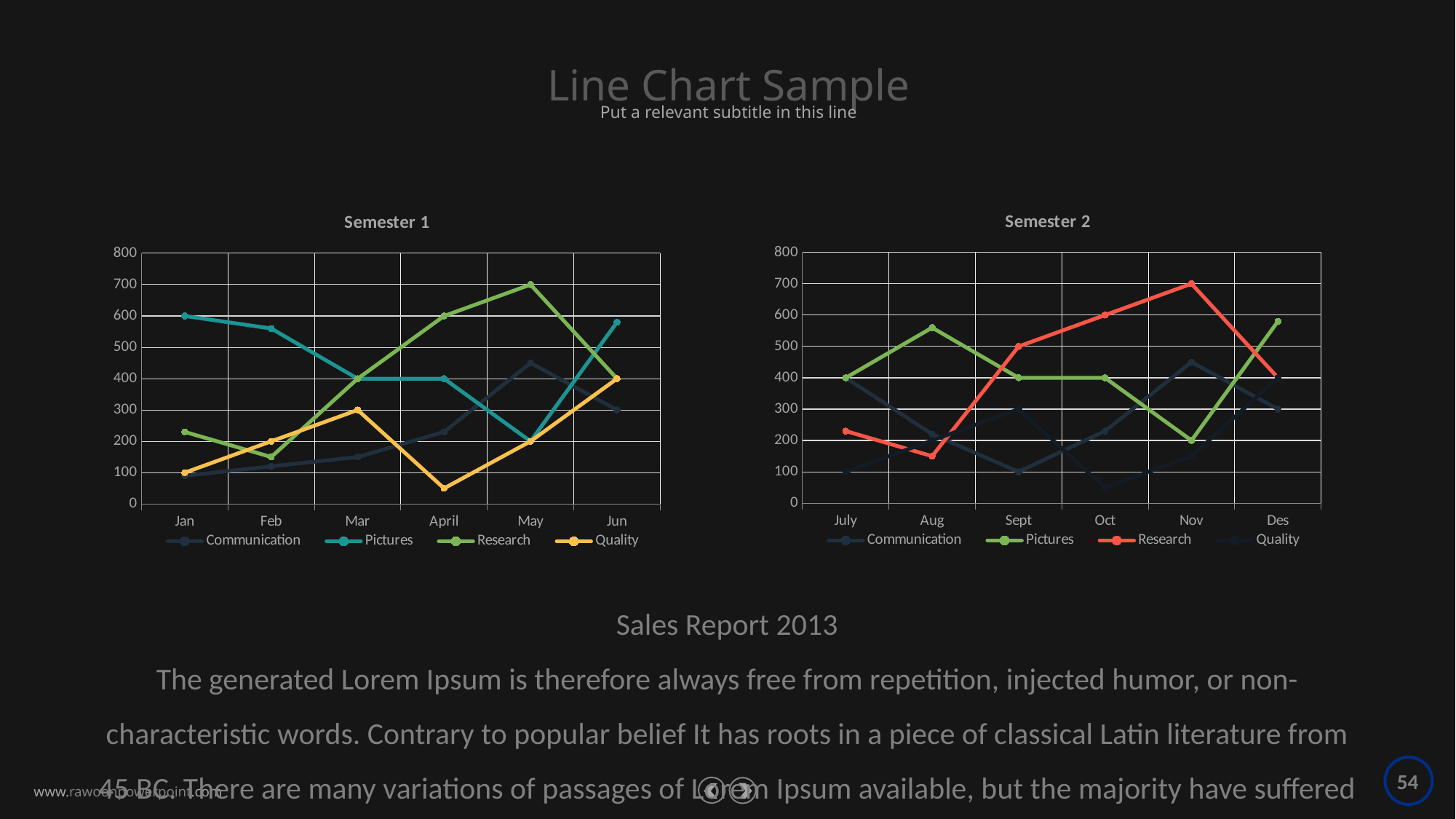
In the Semester 2 chart, in which month does Research reach its highest value? Nov In the Semester 1 chart, is the value for Communication in May greater or less than 400? greater In the Semester 1 chart, what is the value for Pictures in Jan? 600 How many months are shown on the x axis of the Semester 1 chart? 6 In the Semester 1 chart, what is the value for Research in May? 700 In the Semester 1 chart, in which month does Research reach its highest value? May In the Semester 1 chart, what is the value for Quality in Mar? 300 In the Semester 2 chart, what is the value for Research in Nov? 700 How many series does the legend of the Semester 2 chart list? 4 In the Semester 2 chart, what is the value for Pictures in Nov? 200 In the Semester 1 chart, which is larger in Jan: Pictures or Research? Pictures What kind of chart is the Semester 1 chart? line chart